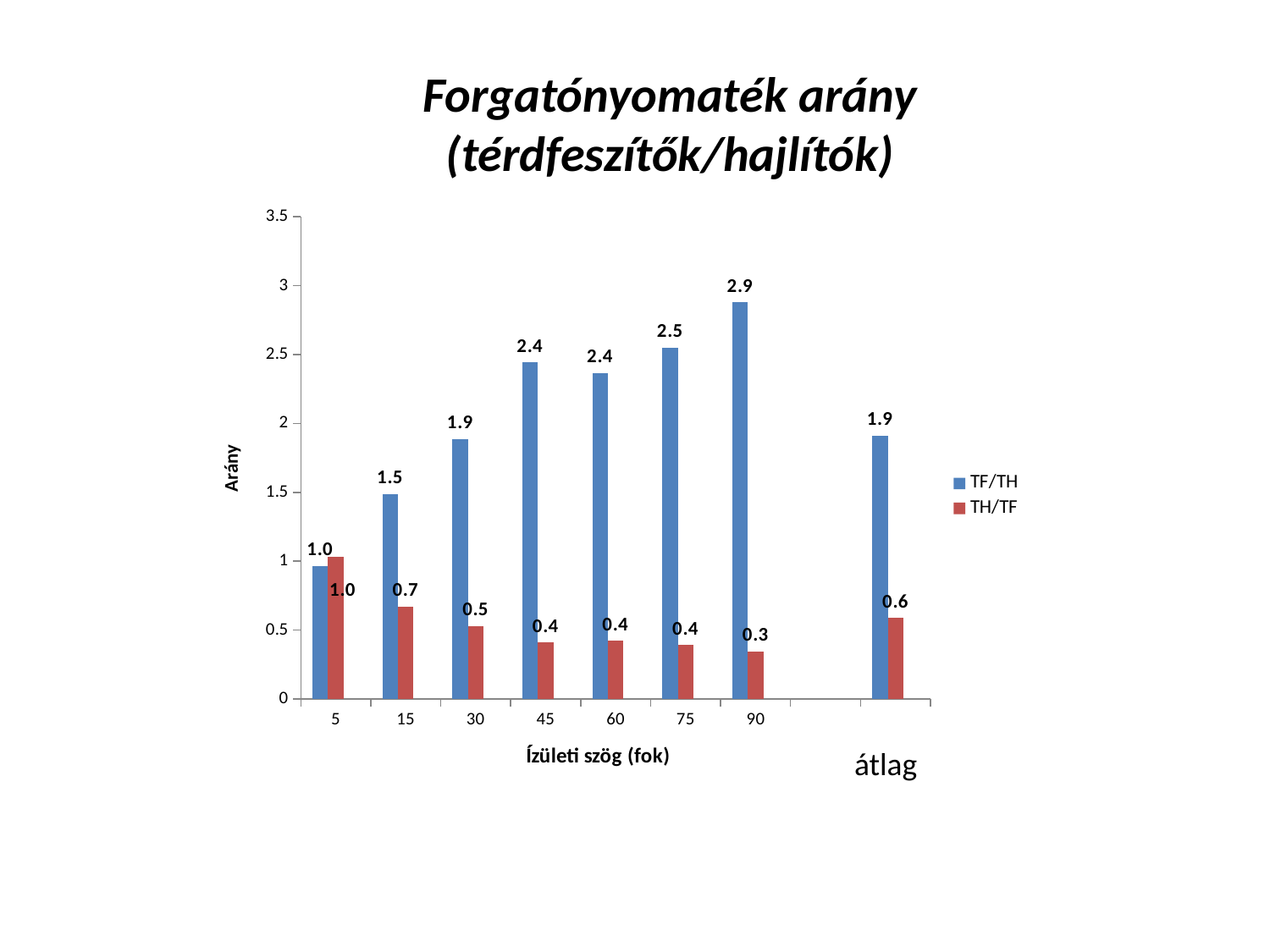
How many joint angle values are shown on the x axis (excluding átlag)? 7 Is the TF/TH value at 75 degrees greater or less than 2? greater What is the average (átlag) TH/TF value shown? 0.6 Which is larger: the TF/TH value at 45 degrees or at 15 degrees? 45 degrees What is the difference between the TF/TH value at 90 degrees and at 5 degrees? 1.9 At which joint angle is the TH/TF ratio lowest? 90 What is the average (átlag) TF/TH value shown? 1.9 What is the TF/TH value at a joint angle of 90 degrees? 2.9 At which joint angle is the TF/TH ratio highest? 90 How many series does the legend list? 2 What kind of chart is shown on the slide? bar chart What is the TH/TF value at a joint angle of 15 degrees? 0.7